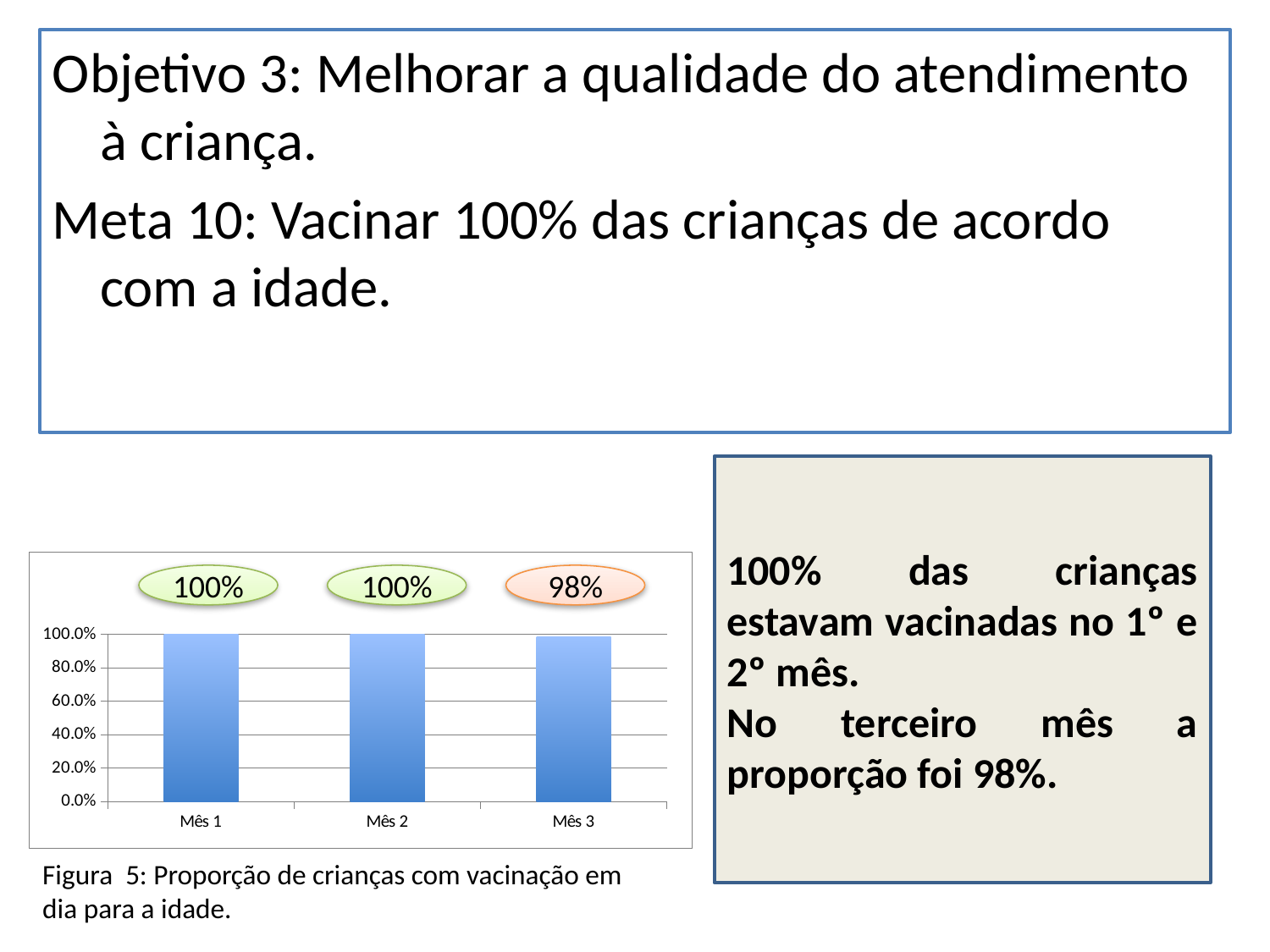
How many months (categories) are shown in the chart? 3 What colour are the bars in the chart? blue What is the value for Mês 2 in the chart? 100% What is the difference between the values for Mês 1 and Mês 3? 2% What is the value for Mês 3 in the chart? 98% What is the figure caption given below the chart? Figura 5: Proporção de crianças com vacinação em dia para a idade. Which is larger, the value for Mês 2 or the value for Mês 3? Mês 2 What is the value for Mês 1 in the chart? 100% Is the value for Mês 3 greater or less than 80.0%? greater What kind of chart is shown on the slide? bar chart Which month has the lowest value in the chart? Mês 3 Do the values rise, fall or stay the same from Mês 2 to Mês 3? fall